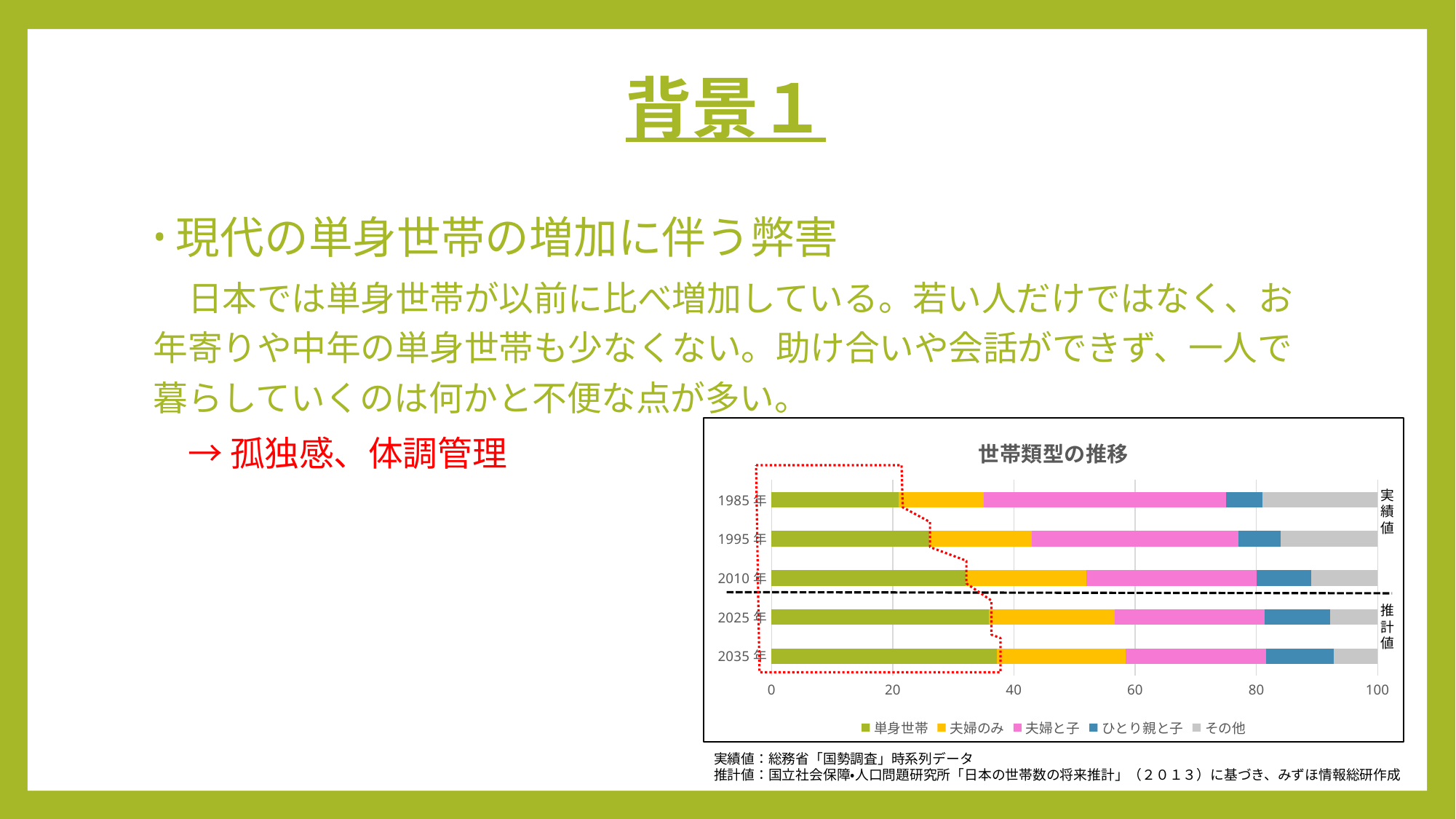
Is the 単身世帯 value for 2010年 greater or less than 20? greater What is the title of the chart? 世帯類型の推移 Is the 単身世帯 share larger in 2010年 or in 1995年? 2010年 Is the 単身世帯 share larger in 2035年 or in 1985年? 2035年 Which series is listed first in the legend? 単身世帯 Does the 単身世帯 share rise or fall from 1985年 to 2035年? rise Which year has the smallest 単身世帯 share? 1985年 What kind of chart is shown on the slide? stacked bar chart How many series does the chart legend list? 5 How many years (categories) are plotted in the chart? 5 Is the 単身世帯 value for 2035年 greater or less than 40? less Is the 単身世帯 value for 2035年 greater or less than 20? greater